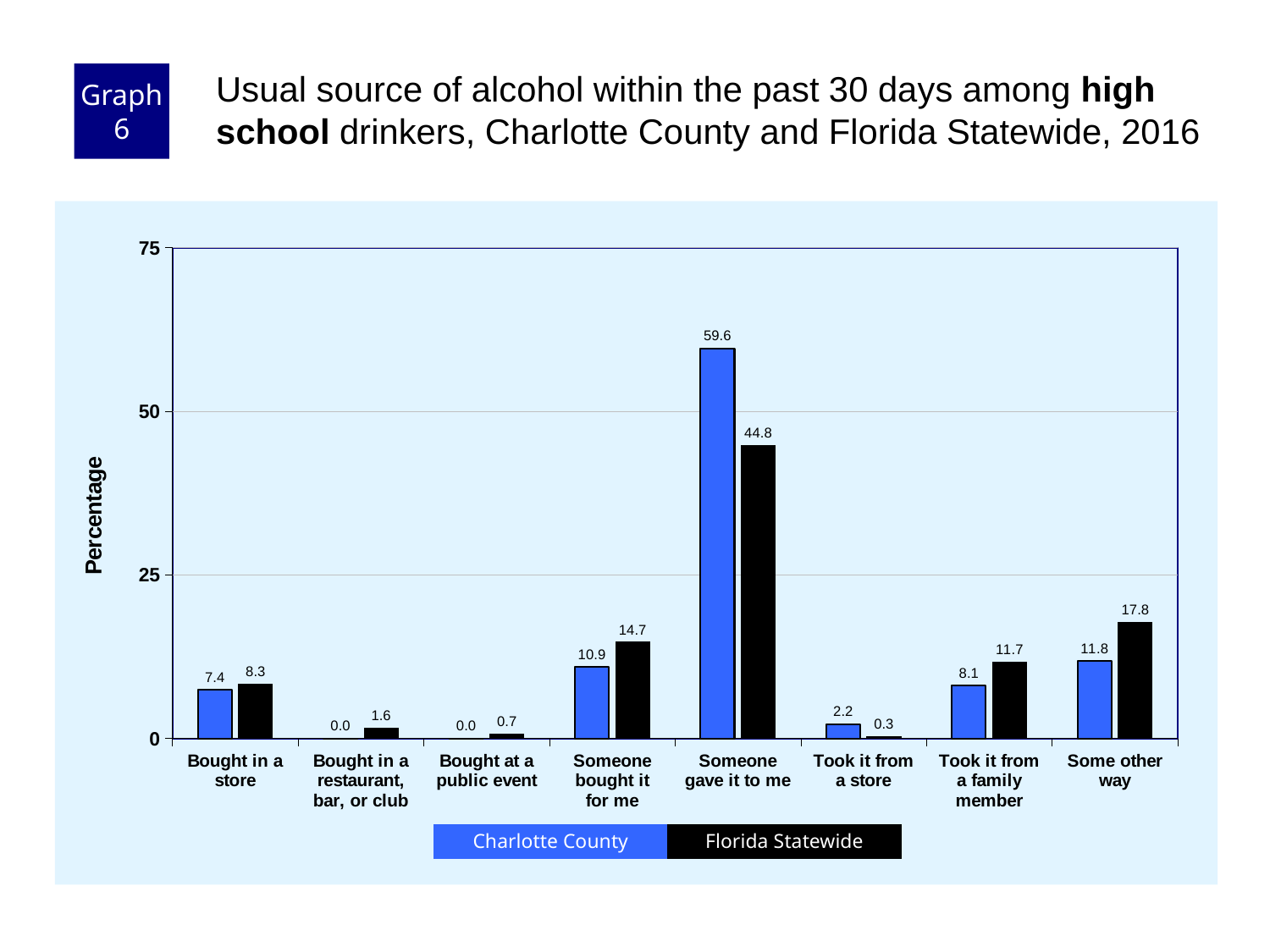
Which category has the highest Florida Statewide value? Someone gave it to me What is the label of the y axis? Percentage What kind of chart is shown on the slide? bar chart What is the Charlotte County value for "Someone gave it to me"? 59.6 What is the difference between the Charlotte County and Florida Statewide values for "Someone gave it to me"? 14.8 Is the Florida Statewide value for "Someone gave it to me" greater or less than 50? less Which is larger for "Someone bought it for me": Charlotte County or Florida Statewide? Florida Statewide What is the Florida Statewide value for "Some other way"? 17.8 How many series does the legend list? 2 What is the Charlotte County value for "Took it from a family member"? 8.1 How many categories are shown on the x axis? 8 Which category has the lowest Florida Statewide value? Took it from a store